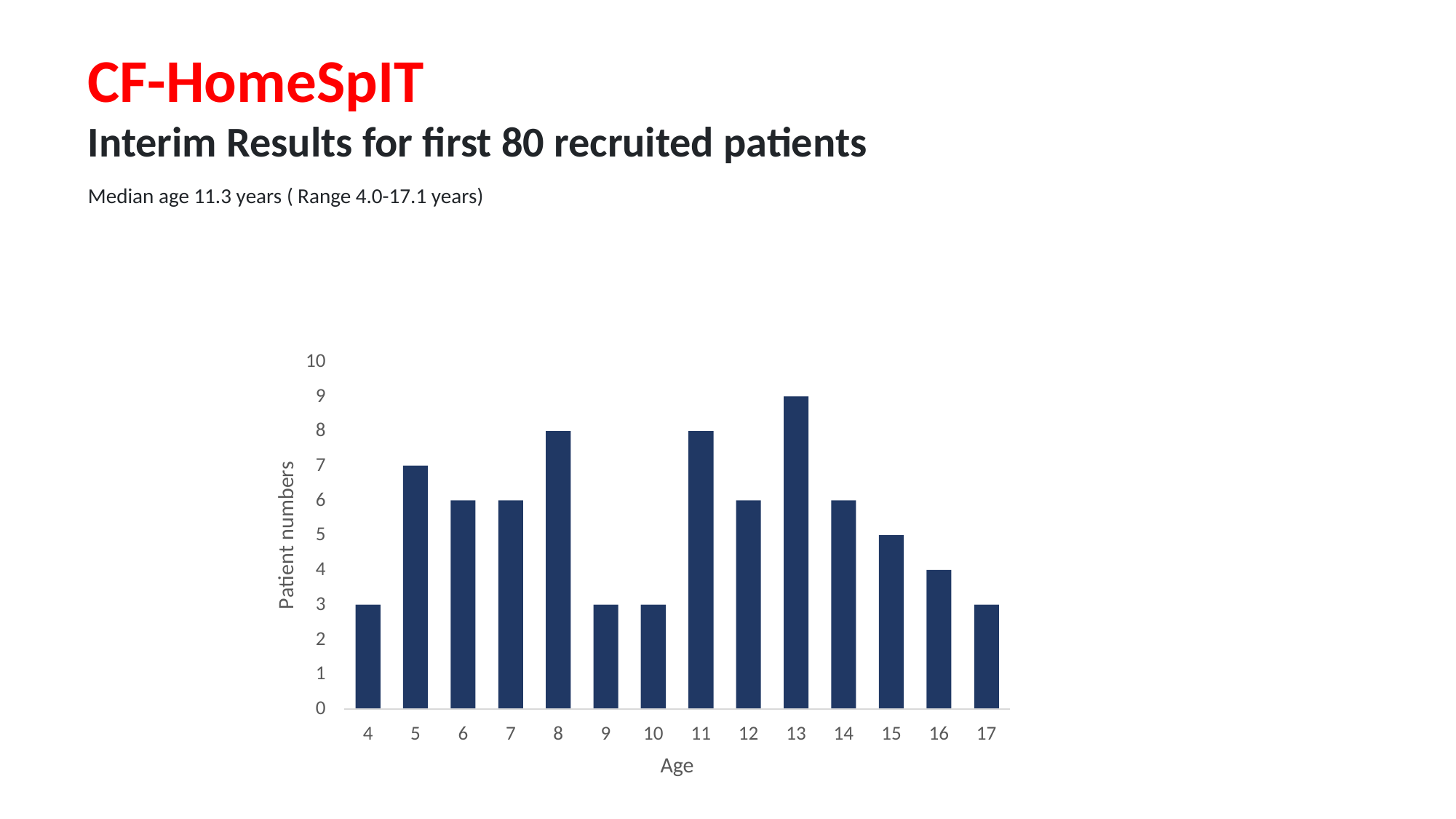
Which is larger, the patient number for age 8 or for age 9? age 8 Which age has the highest number of patients? 13 What kind of chart is shown on the slide? bar chart What is the label of the y axis of the chart? Patient numbers What is the label of the x axis of the chart? Age Is the patient number for age 11 greater or less than 5? greater What is the patient number for age 16? 4 What is the patient number for age 5? 7 What is the patient number for age 15? 5 How many age categories are shown on the x axis of the chart? 14 What is the patient number for age 13? 9 What is the difference between the patient numbers for age 13 and age 17? 6